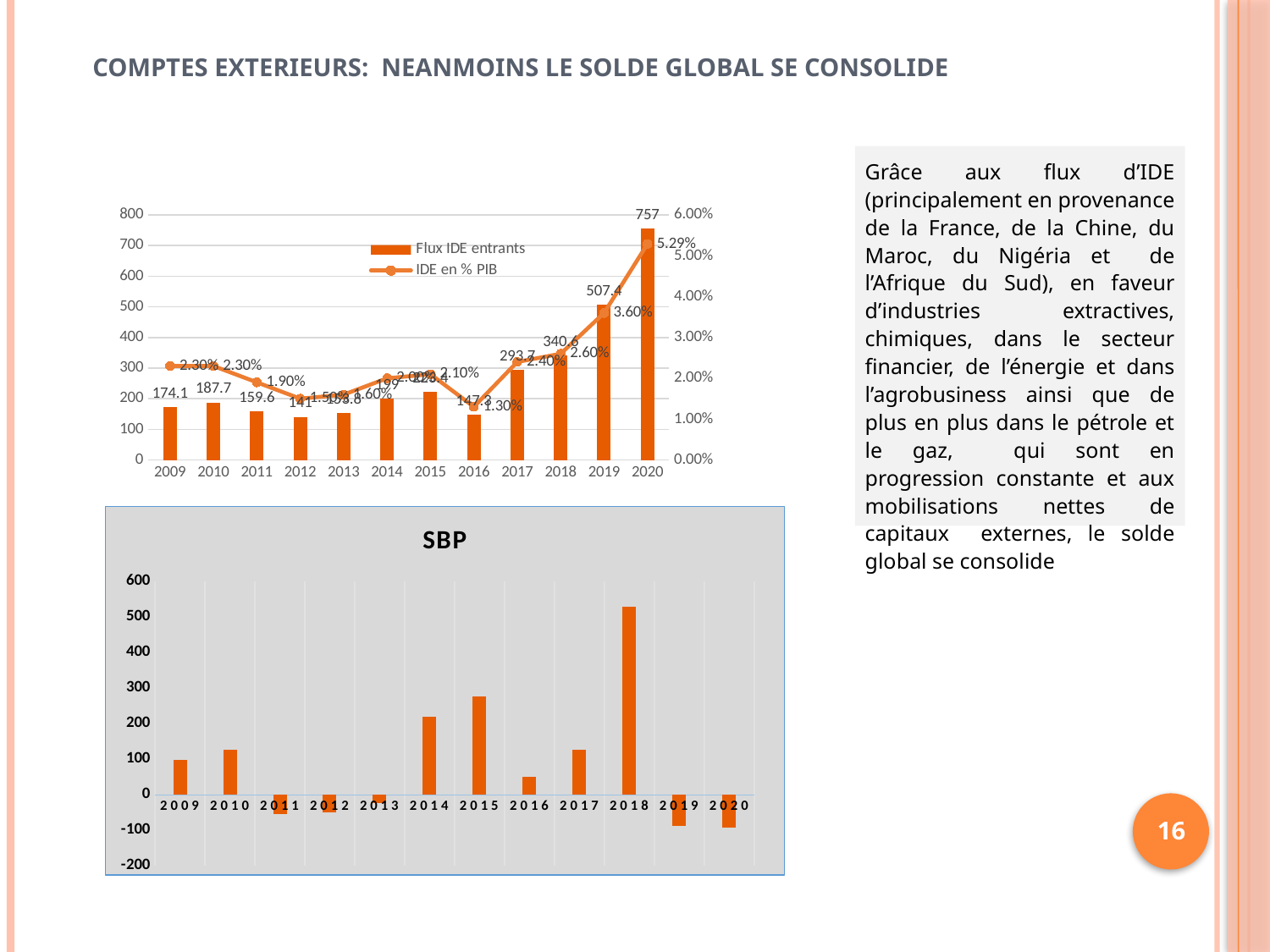
In the top chart, what is the IDE en % PIB value for 2019? 3.60% In the top chart, do the Flux IDE entrants values rise or fall from 2016 to 2020? rise In the SBP chart, which year has the highest value? 2018 What kind of chart is the SBP chart? bar chart In the top chart, which year has the larger Flux IDE entrants, 2009 or 2010? 2010 In the top chart, what is the difference in Flux IDE entrants between 2020 and 2019? 249.6 In the top chart, what is the value of Flux IDE entrants for 2020? 757 In the top chart, which year has the highest Flux IDE entrants? 2020 In the top chart, what is the Flux IDE entrants value for 2009? 174.1 In the SBP chart, is the value for 2015 greater or less than 200? greater How many series does the legend of the top chart list? 2 In the top chart, which year has the lowest IDE en % PIB value? 2016